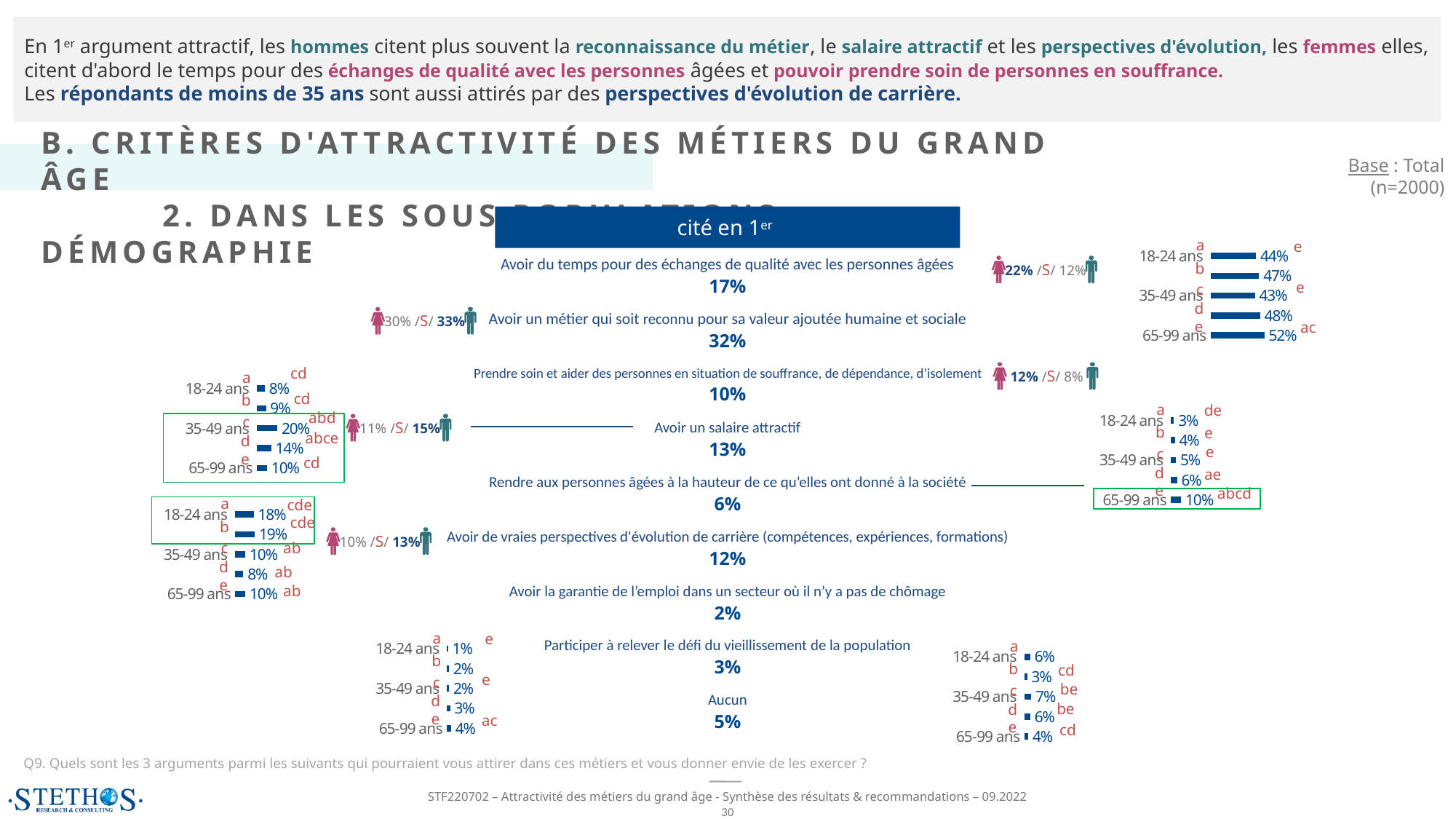
What kind of chart is used for the age-group breakdowns on this slide? bar chart In the top-right bar chart (next to 'Avoir un métier qui soit reconnu pour sa valeur ajoutée humaine et sociale'), what is the value for 65-99 ans? 52% In the left bar chart beside 'Avoir de vraies perspectives d'évolution de carrière', what is the value for 18-24 ans? 18% In the bottom-left bar chart, what is the value for 65-99 ans? 4% In the left bar chart beside 'Avoir un salaire attractif', what is the value for 35-49 ans? 20% In the right bar chart beside 'Rendre aux personnes âgées à la hauteur de ce qu'elles ont donné à la société', what is the value for 65-99 ans? 10% In the left bar chart beside 'Avoir un salaire attractif', what is the difference between the values for 35-49 ans and 18-24 ans? 12 percentage points In the left bar chart beside 'Avoir de vraies perspectives d'évolution de carrière', which is larger: the value for 18-24 ans or for 65-99 ans? 18-24 ans In the right bar chart beside 'Rendre aux personnes âgées à la hauteur de ce qu'elles ont donné à la société', do the values rise or fall from 18-24 ans to 65-99 ans? rise In the bottom-right bar chart, what is the value for 35-49 ans? 7% How many bars does the top-right bar chart contain? 5 In the top-right bar chart, which age group has the highest value? 65-99 ans